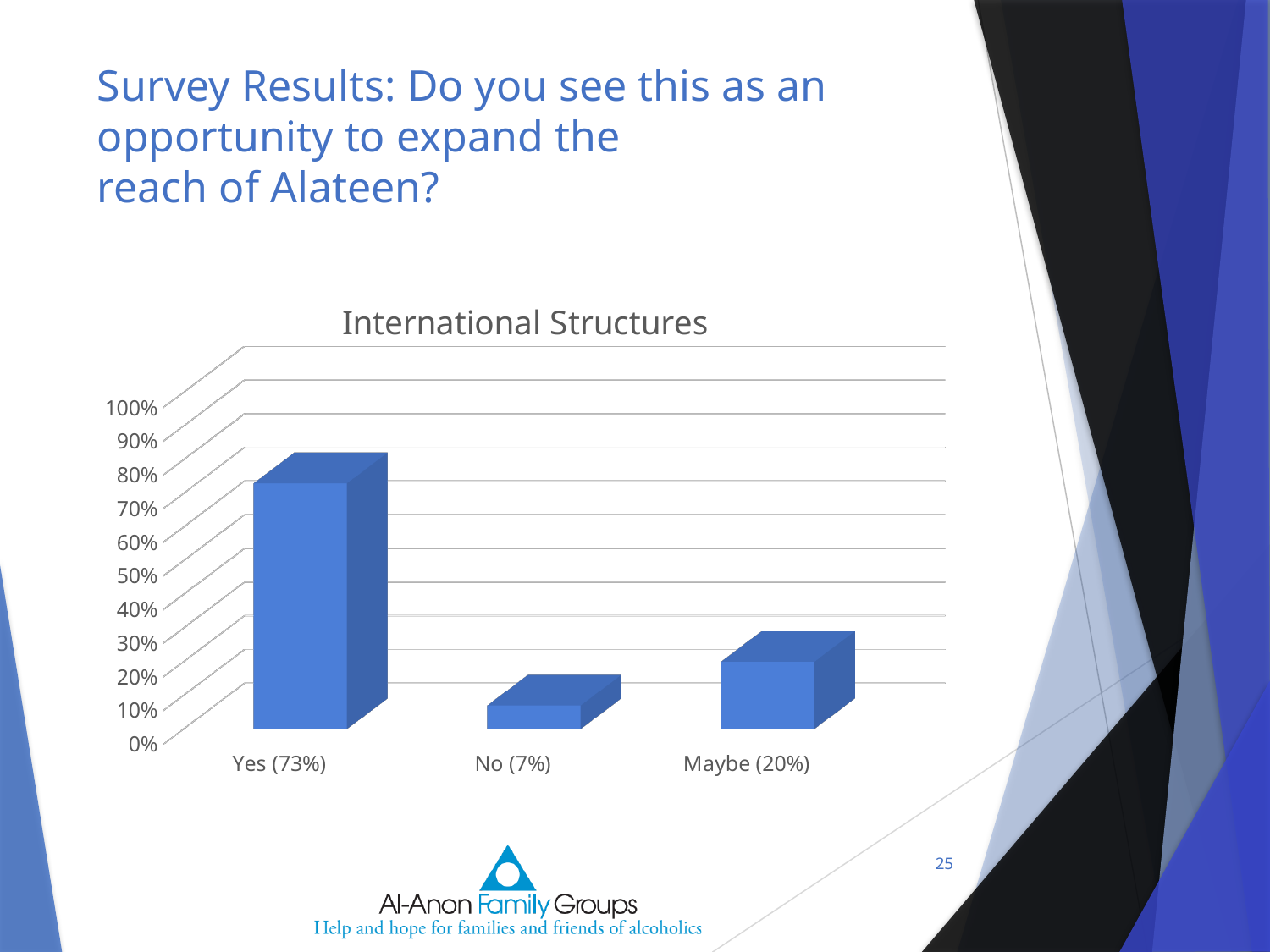
What is the title of the chart? International Structures Which response category has the highest value? Yes Is the value for Yes greater or less than 50%? greater What percentage of respondents answered Maybe? 20% Which is larger, the value for Maybe or the value for No? Maybe How many categories are shown in the chart? 3 What is the difference between the Maybe and No percentages? 13% Which response category has the lowest value? No What percentage of respondents answered Yes? 73% What is the difference between the Yes and Maybe percentages? 53% What kind of chart is shown on the slide? bar chart What percentage of respondents answered No? 7%